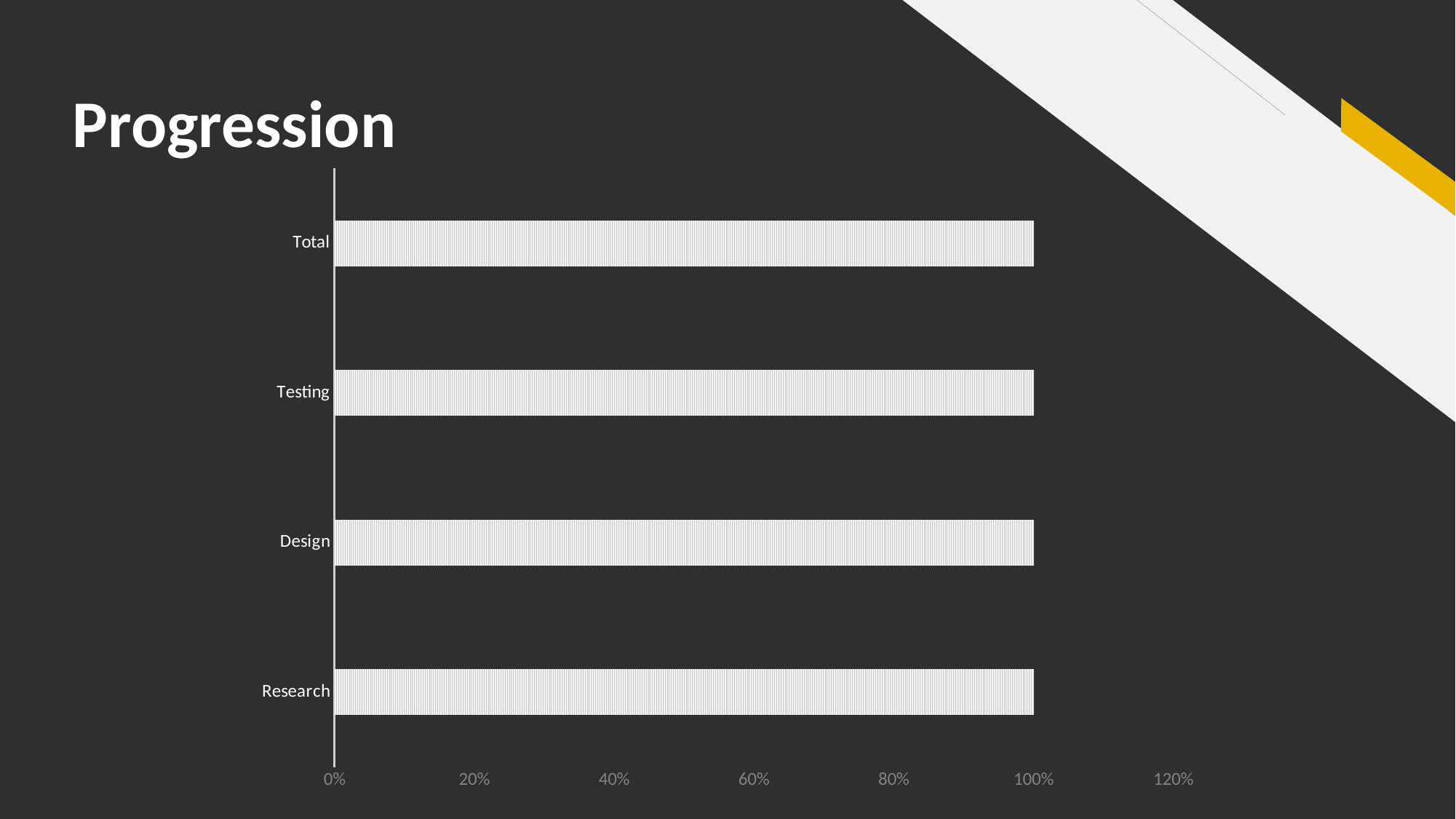
How many categories are plotted in the chart? 4 What is the value for Total? 100% What is the difference between the values for Total and Design? 0% What type of chart is shown on the slide? bar chart What is the value for Research? 100% Is the value for Testing greater or less than 80%? greater What is the title of the slide containing the chart? Progression What is the highest value shown on the horizontal axis? 120% Which category label appears at the top of the chart? Total What is the value for Design? 100% Is the value for Research greater or less than 120%? less What is the value for Testing? 100%